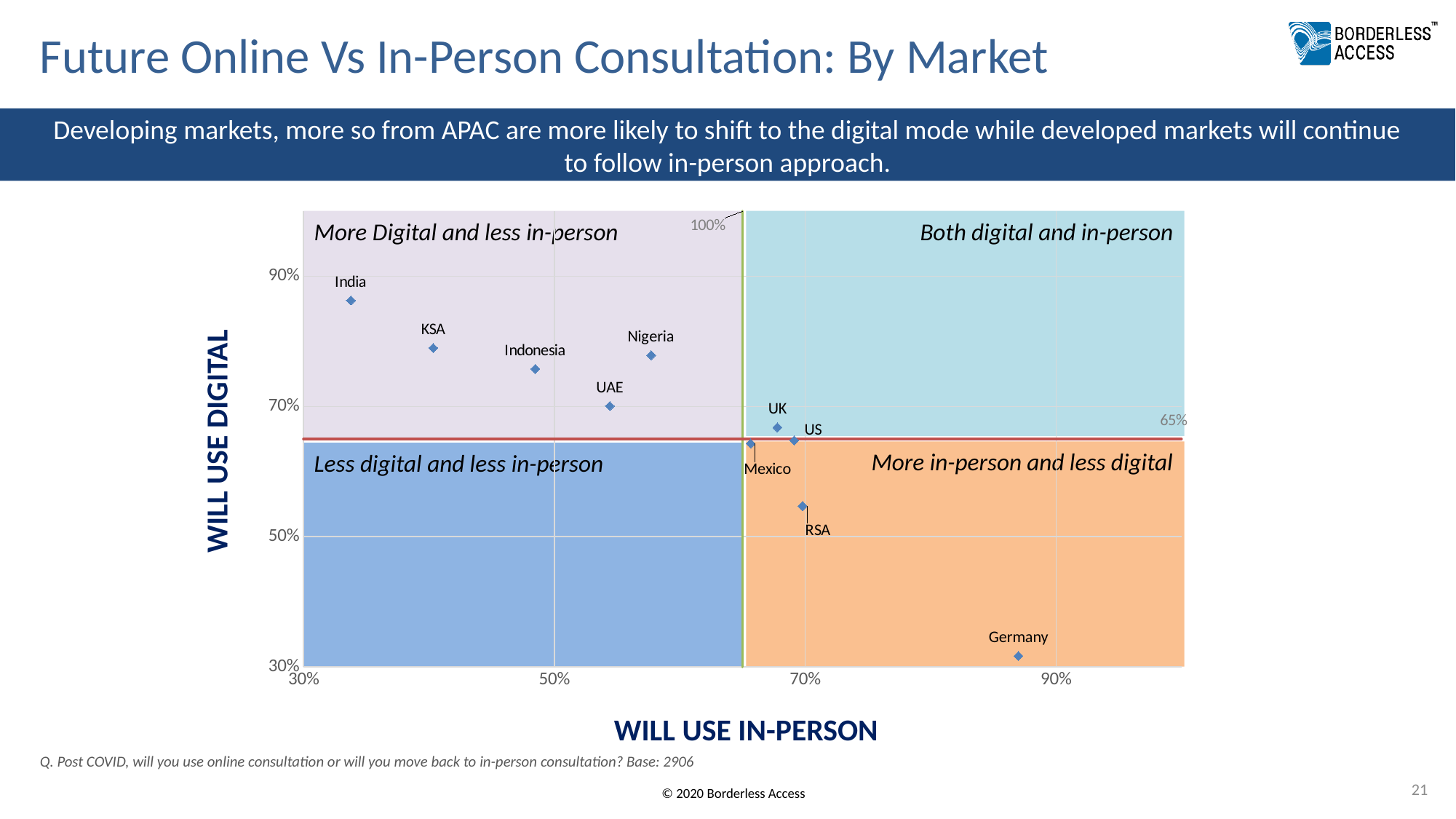
Is the 'will use in-person' value for Germany greater or less than 70%? greater How many markets are plotted on the chart? 10 What kind of chart is shown on the slide? Scatter chart Which market has the lowest 'will use in-person' value? India Is the 'will use digital' value for India greater or less than 70%? greater Which market has the highest 'will use digital' value? India Is the 'will use digital' value for Germany greater or less than 50%? less Which market has the highest 'will use in-person' value? Germany What is the title of the horizontal axis of the chart? WILL USE IN-PERSON Which market has the lowest 'will use digital' value? Germany Which market has a higher 'will use in-person' value, UK or Germany? Germany Which market has a higher 'will use digital' value, KSA or Indonesia? KSA